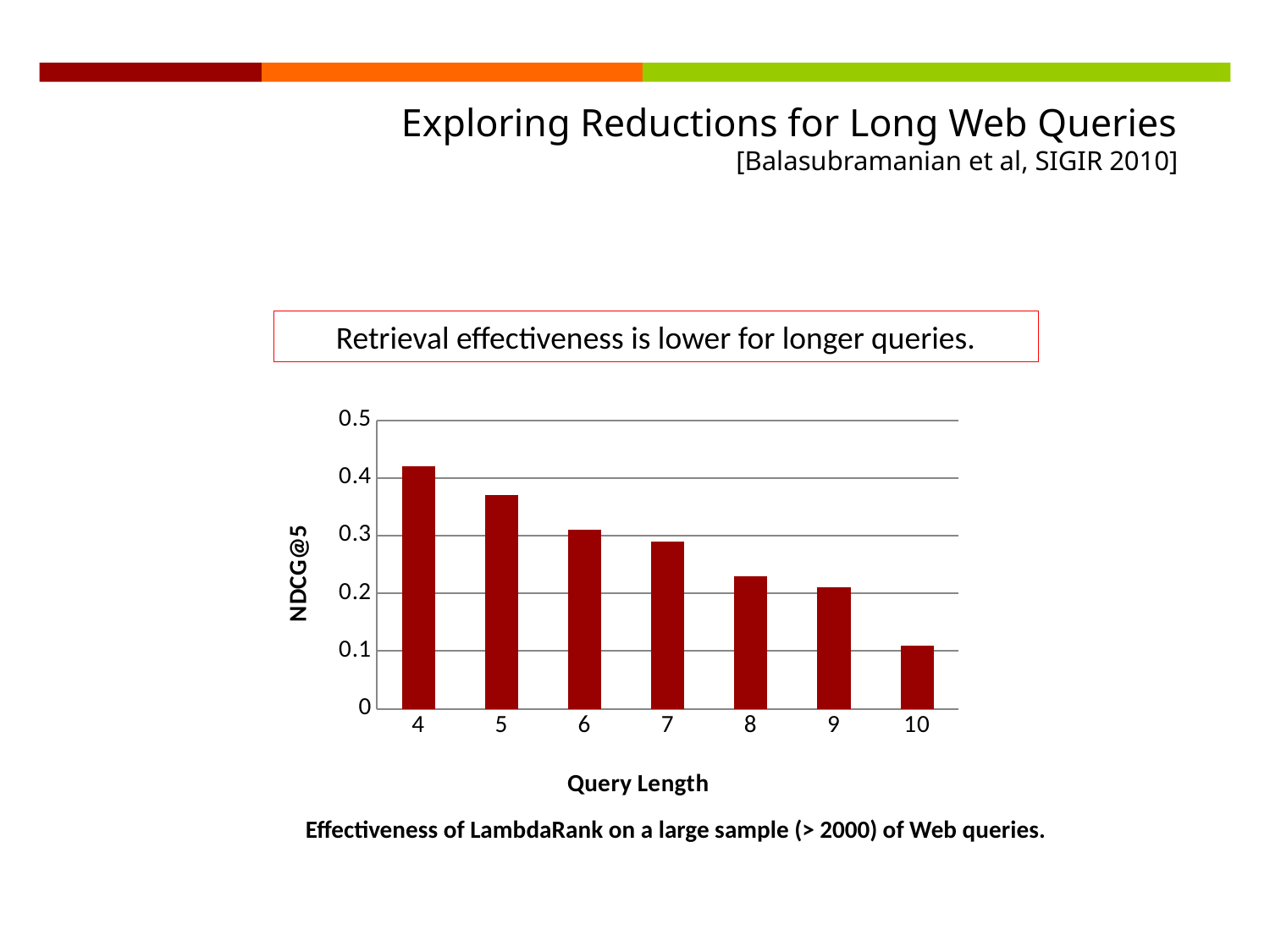
Is the NDCG@5 value for query length 10 greater or less than 0.2? less Which has a higher NDCG@5, query length 5 or query length 9? query length 5 What kind of chart is shown on the slide? bar chart Which query length has the highest NDCG@5 in the chart? 4 How many query lengths are plotted on the x axis of the chart? 7 What is the label of the x axis of the chart? Query Length What is the label of the y axis of the chart? NDCG@5 Is the NDCG@5 value for query length 4 greater or less than 0.4? greater Which query length has the lowest NDCG@5 in the chart? 10 Is the NDCG@5 value for query length 8 greater or less than 0.3? less Does NDCG@5 rise or fall as query length increases along the x axis? fall